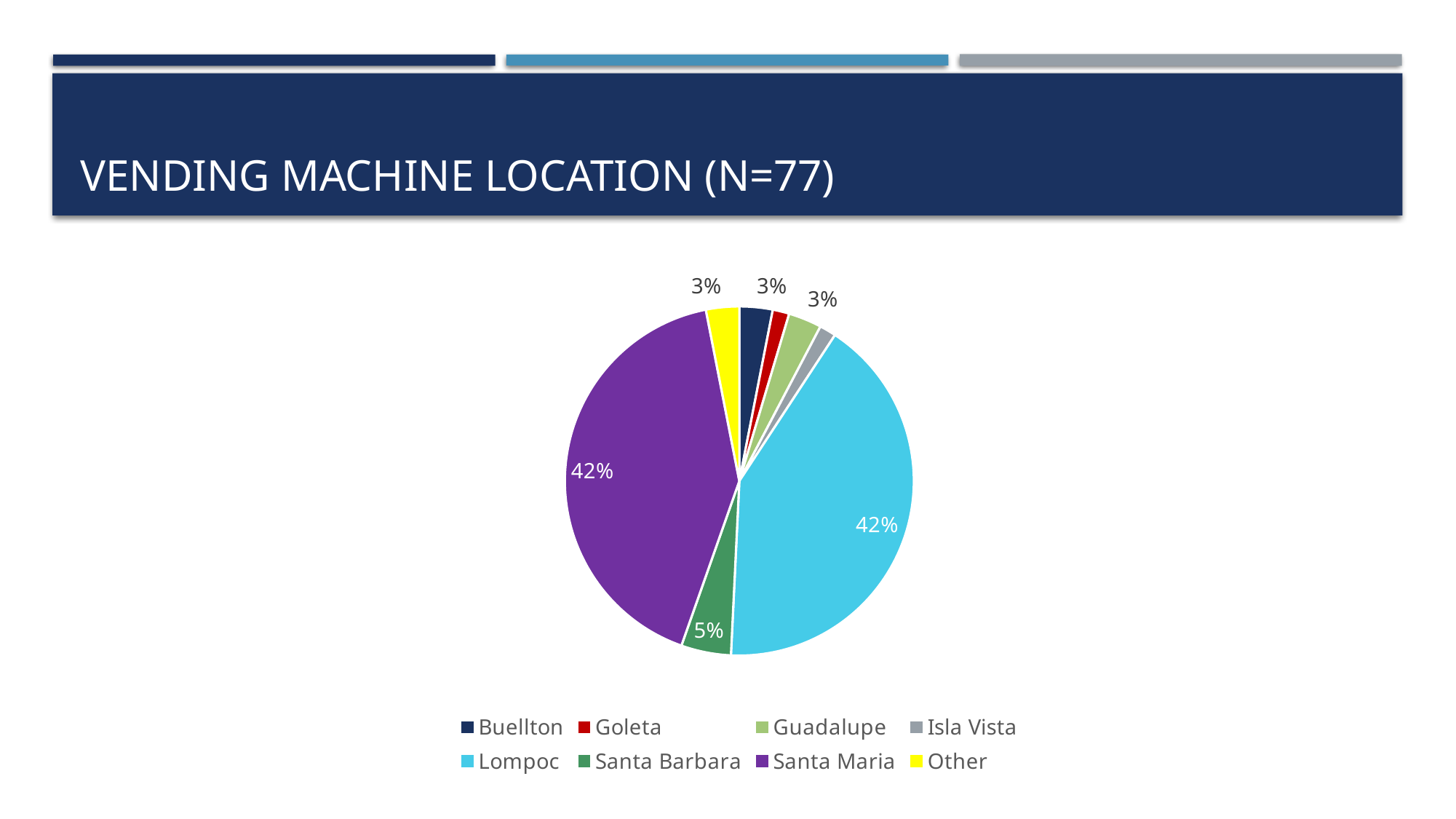
What share of the pie does Santa Maria have? 42% How many categories does the legend list? 8 What is the value for Other? 3% Which is larger, the slice for Lompoc or the slice for Santa Barbara? Lompoc What is the title of the chart? VENDING MACHINE LOCATION (N=77) What is the value for Buellton? 3% What kind of chart is shown on the slide? pie chart What colour is the Santa Maria slice? purple What is the value for Guadalupe? 3% What is the value for Santa Barbara? 5% What is the difference between the Santa Maria share and the Santa Barbara share? 37% What share of the pie does Lompoc have? 42%